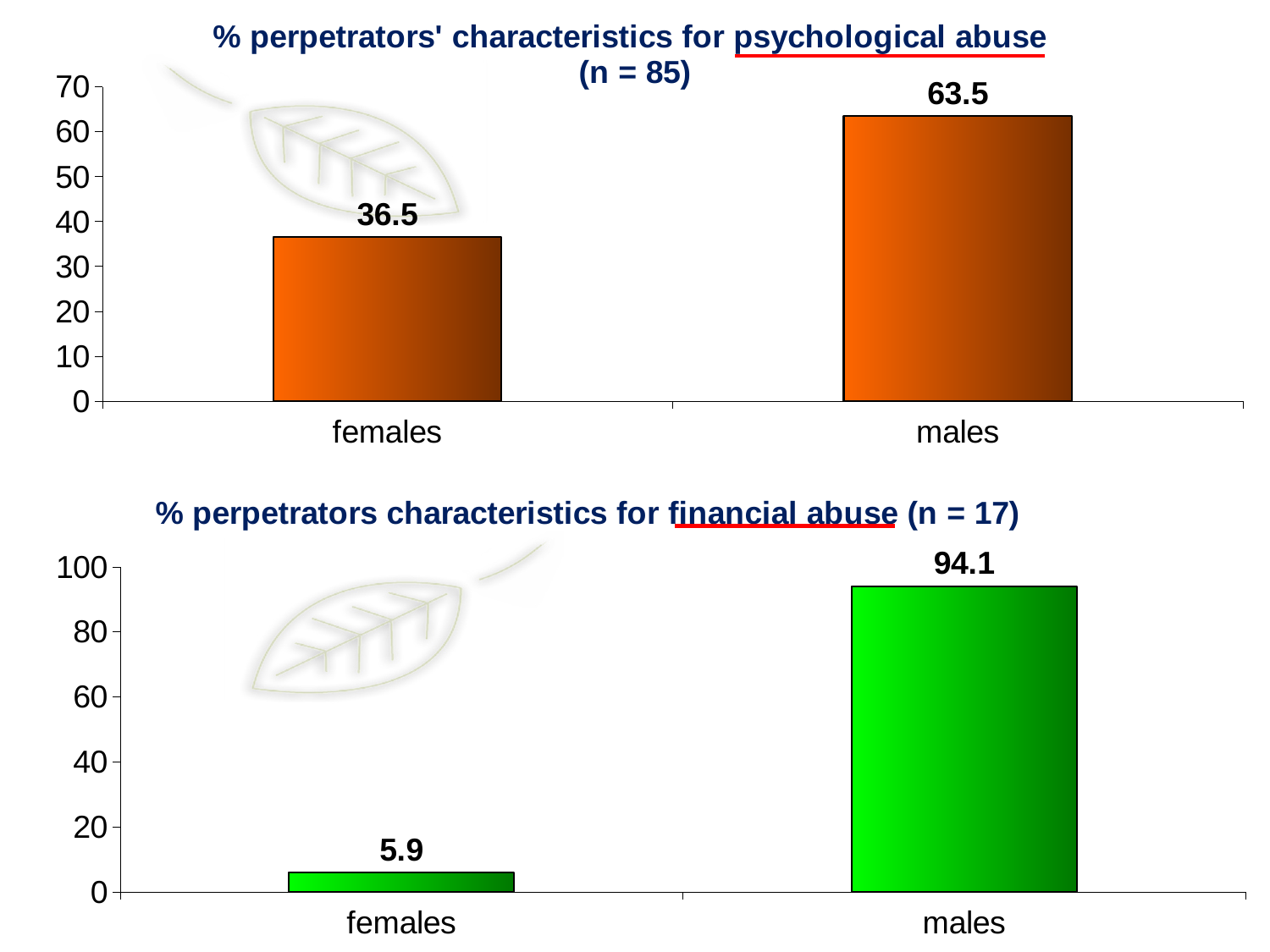
In the psychological abuse chart (top), which category has the highest value? males What kind of chart is the financial abuse chart (bottom)? bar chart What is the sample size (n) given in the title of the financial abuse chart (bottom)? 17 In the psychological abuse chart (top), what is the value for females? 36.5 In the psychological abuse chart (top), what is the value for males? 63.5 In the financial abuse chart (bottom), is the value for males greater or less than 80? greater In the financial abuse chart (bottom), what is the value for males? 94.1 In the psychological abuse chart (top), what is the difference between the values for males and females? 27 In the financial abuse chart (bottom), which category has the lowest value? females In the financial abuse chart (bottom), what is the difference between the values for males and females? 88.2 In the financial abuse chart (bottom), what is the value for females? 5.9 How many categories are shown in the psychological abuse chart (top)? 2